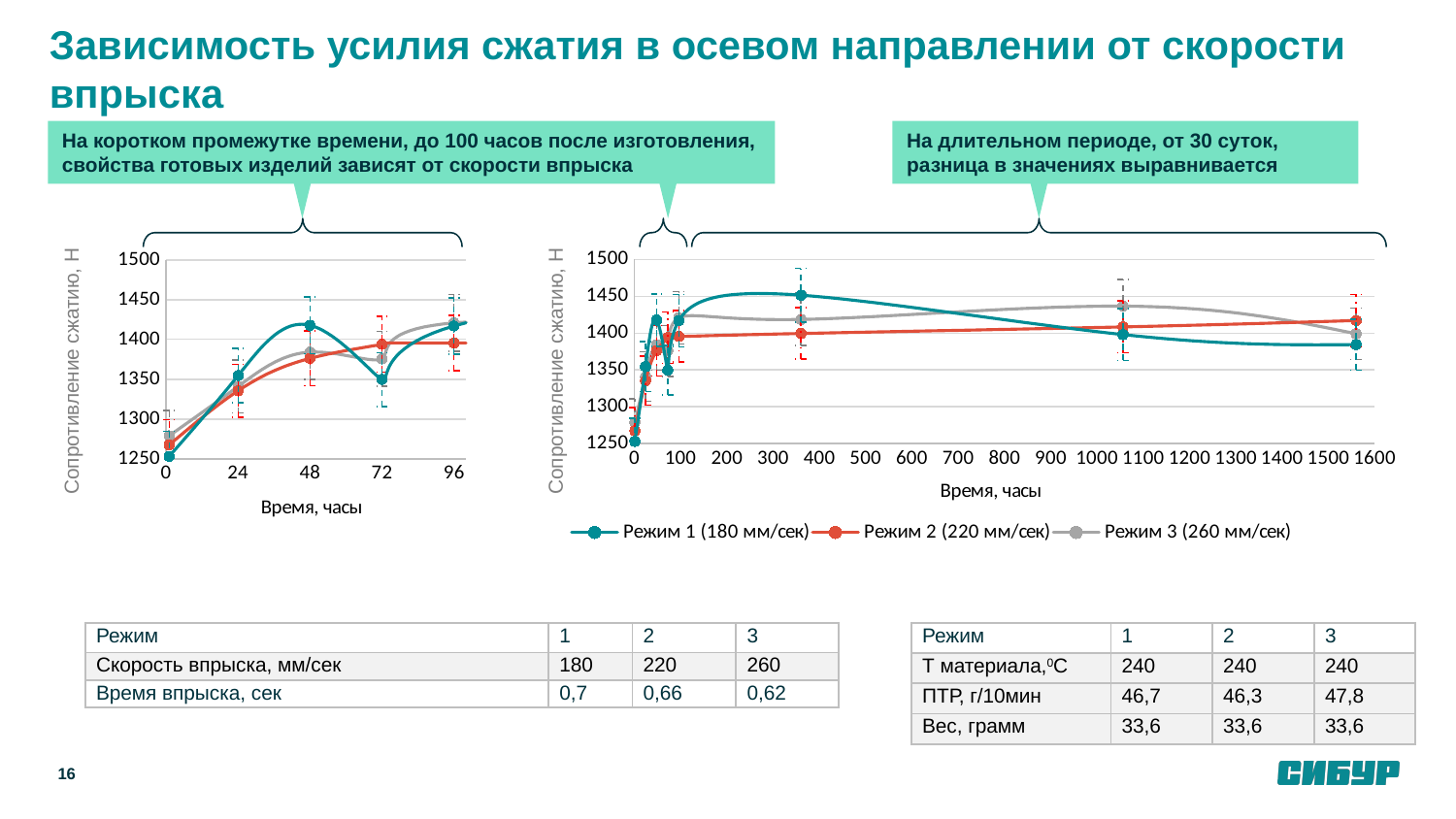
In the left chart, does the value for Режим 2 rise or fall from 0 to 96 hours? rise In the right chart, is the value for Режим 1 at the last point near 1600 hours greater or less than 1400? less What is the label of the first series in the legend? Режим 1 (180 мм/сек) What is the y-axis title of the right chart? Сопротивление сжатию, Н What kind of chart is the left chart on the slide? line chart How many series does the legend list for the charts? 3 In the left chart, is the value for Режим 1 at 0 hours greater or less than 1300? less How many tick labels are shown on the x axis of the left chart? 5 In the left chart, at 72 hours, which is larger: Режим 1 or Режим 2? Режим 2 In the right chart, at the last point near 1600 hours, which is larger: Режим 1 or Режим 2? Режим 2 In the left chart, is the value for Режим 1 at 48 hours greater or less than 1400? greater